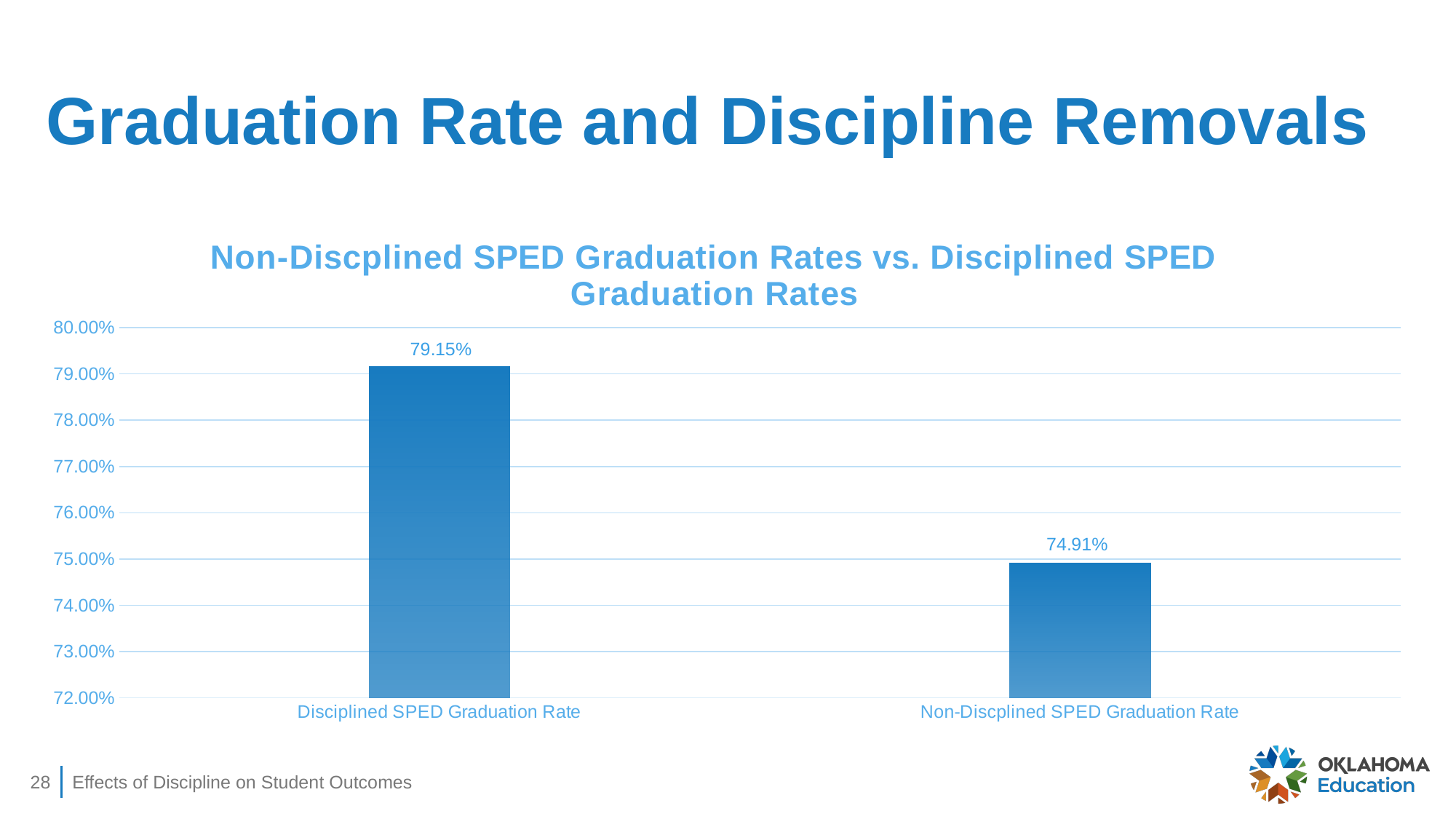
Which category has the lowest value? Non-Discplined SPED Graduation Rate Which category has the highest value? Disciplined SPED Graduation Rate Is the value for Non-Discplined SPED Graduation Rate greater or less than 76.00%? less What is the value for Non-Discplined SPED Graduation Rate? 74.91% What kind of chart is shown on the slide? bar chart What is the difference between the Disciplined SPED Graduation Rate and the Non-Discplined SPED Graduation Rate? 4.24% What is the title of the chart? Non-Discplined SPED Graduation Rates vs. Disciplined SPED Graduation Rates What is the value for Disciplined SPED Graduation Rate? 79.15% What is the lowest value shown on the vertical axis? 72.00% How many categories are shown in the chart? 2 Is the value for Disciplined SPED Graduation Rate greater or less than 78.00%? greater Which is larger, the Disciplined SPED Graduation Rate or the Non-Discplined SPED Graduation Rate? Disciplined SPED Graduation Rate